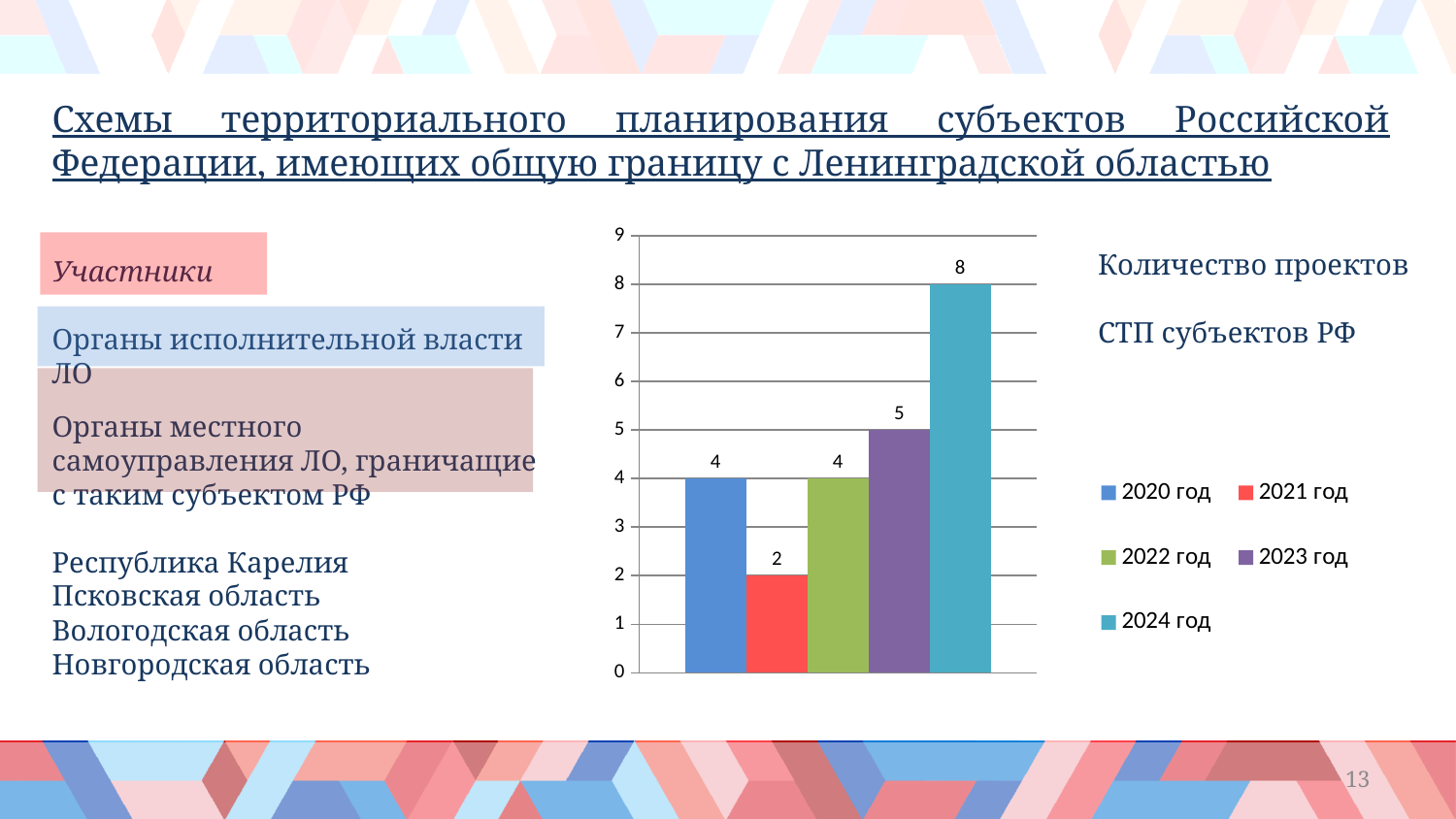
What is the difference between the values for 2024 год and 2023 год? 3 What kind of chart is shown on the slide? bar chart Which year has the highest value? 2024 год What is the difference between the values for 2020 год and 2021 год? 2 What is the value for 2024 год? 8 What is the value for 2023 год? 5 How many series does the legend list? 5 Which year has the lowest value? 2021 год Which is larger, the value for 2023 год or the value for 2022 год? 2023 год What is the value for 2021 год? 2 What colour is the bar for 2021 год? red How many bars are plotted in the chart? 5